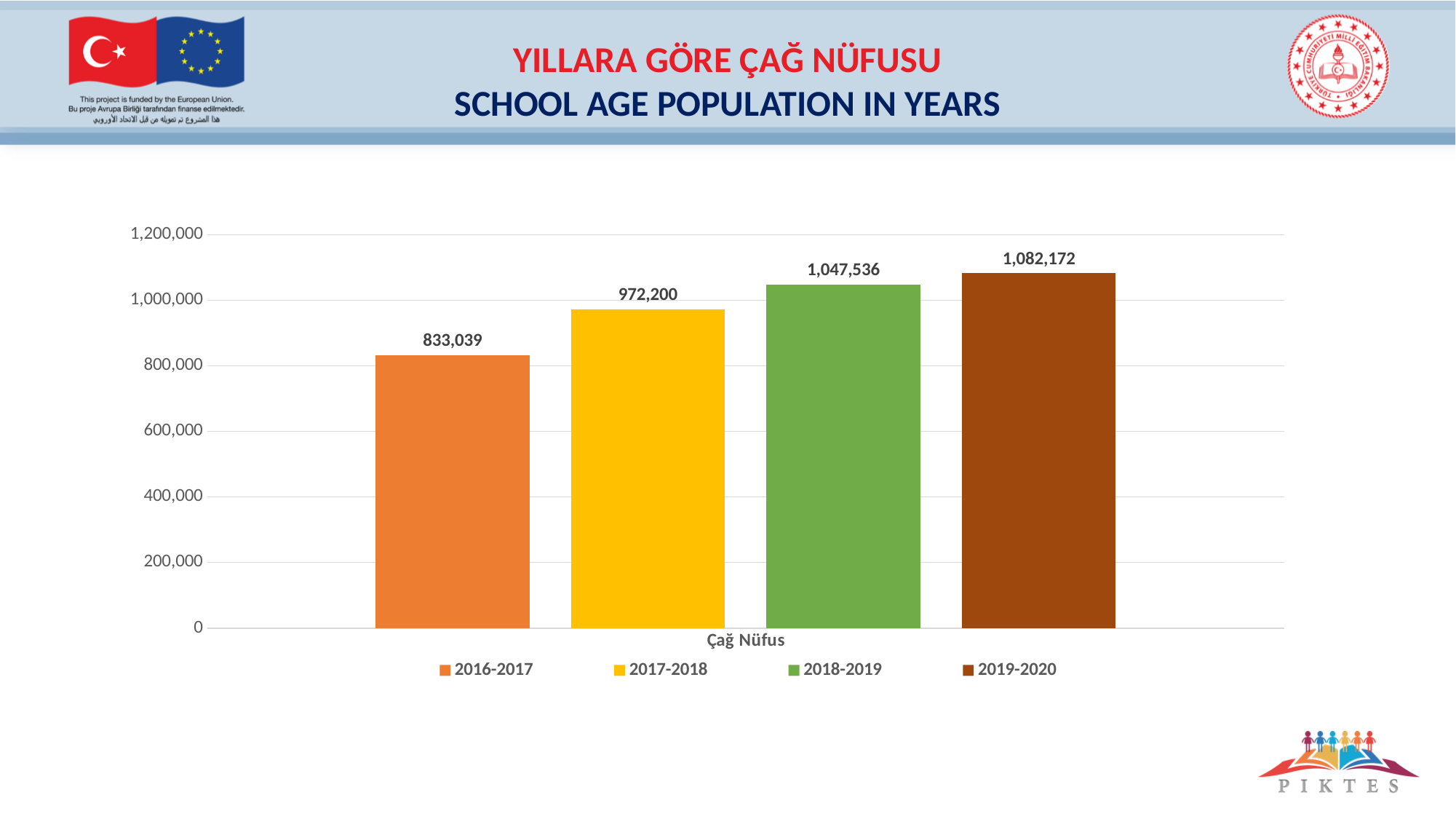
What is the school age population for 2017-2018? 972,200 What is the difference between the school age population in 2019-2020 and in 2016-2017? 249,133 Does the school age population rise or fall from 2016-2017 to 2019-2020? rise Is the school age population for 2017-2018 greater or less than 1,000,000? less What is the school age population for 2019-2020? 1,082,172 Which school year has the highest school age population? 2019-2020 What kind of chart is shown on the slide? bar chart What is the school age population for 2018-2019? 1,047,536 What is the school age population for 2016-2017? 833,039 Which is larger, the school age population in 2017-2018 or in 2018-2019? 2018-2019 How many school years are shown in the chart? 4 Which school year has the lowest school age population? 2016-2017